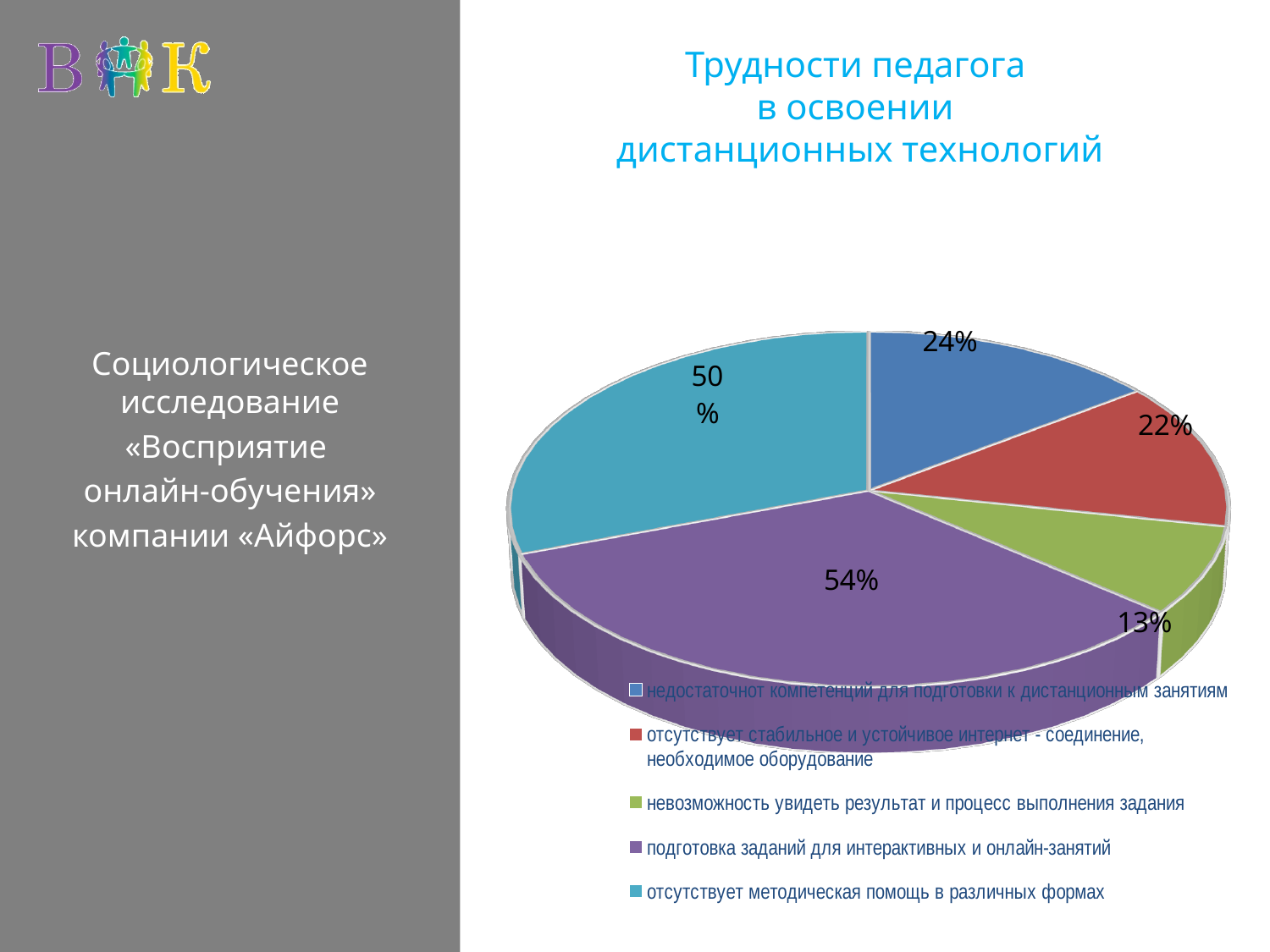
What is the difference between the values for «подготовка заданий для интерактивных и онлайн-занятий» and «отсутствует методическая помощь в различных формах»? 4 percentage points What colour is the slice for «отсутствует стабильное и устойчивое интернет-соединение, необходимое оборудование»? Red What value is shown for «невозможность увидеть результат и процесс выполнения задания»? 13% How many categories does the pie chart legend list? 5 What value is shown for «недостаточно компетенций для подготовки к дистанционным занятиям»? 24% What is the title of the chart? Трудности педагога в освоении дистанционных технологий What value is shown for «подготовка заданий для интерактивных и онлайн-занятий»? 54% Which category has the largest value in the pie chart? подготовка заданий для интерактивных и онлайн-занятий Which category has the smallest value in the pie chart? невозможность увидеть результат и процесс выполнения задания What kind of chart is shown on the slide? Pie chart Which is larger: the value for «недостаточно компетенций для подготовки к дистанционным занятиям» or for «отсутствует стабильное и устойчивое интернет-соединение, необходимое оборудование»? недостаточно компетенций для подготовки к дистанционным занятиям What value is shown for «отсутствует методическая помощь в различных формах»? 50%